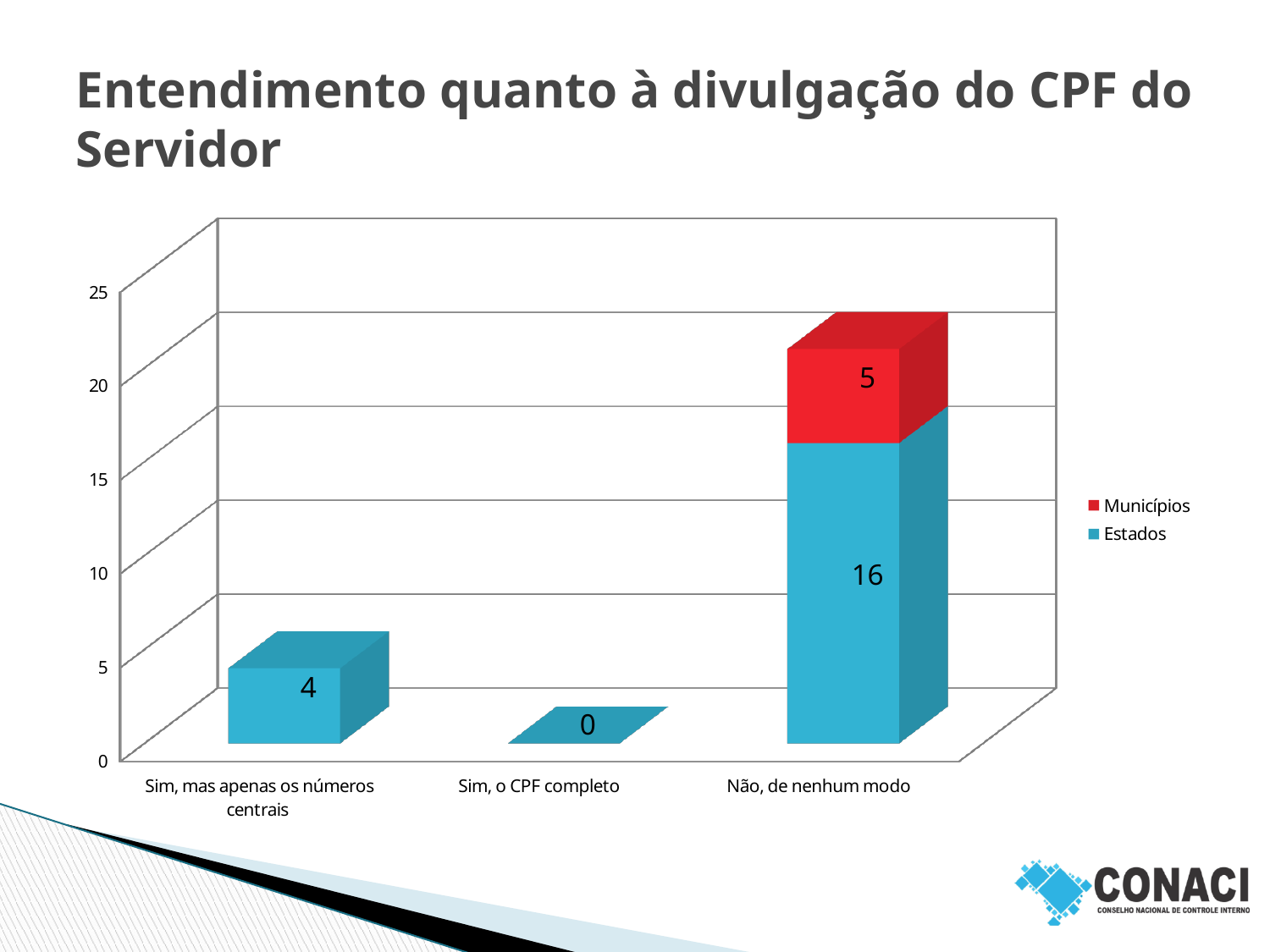
What is the difference between the Estados values for "Não, de nenhum modo" and "Sim, mas apenas os números centrais"? 12 What kind of chart is shown on the slide? Stacked bar chart What is the value for Estados in the "Sim, mas apenas os números centrais" category? 4 In the "Não, de nenhum modo" category, which series has the larger value, Estados or Municípios? Estados Which category has the highest value for Estados? Não, de nenhum modo What is the value for Estados in the "Não, de nenhum modo" category? 16 How many categories are shown on the x axis? 3 What is the value for Municípios in the "Não, de nenhum modo" category? 5 What is the value for Estados in the "Sim, o CPF completo" category? 0 Which category has the lowest value for Estados? Sim, o CPF completo How many series does the legend list? 2 What is the total of the stacked bar for "Não, de nenhum modo"? 21